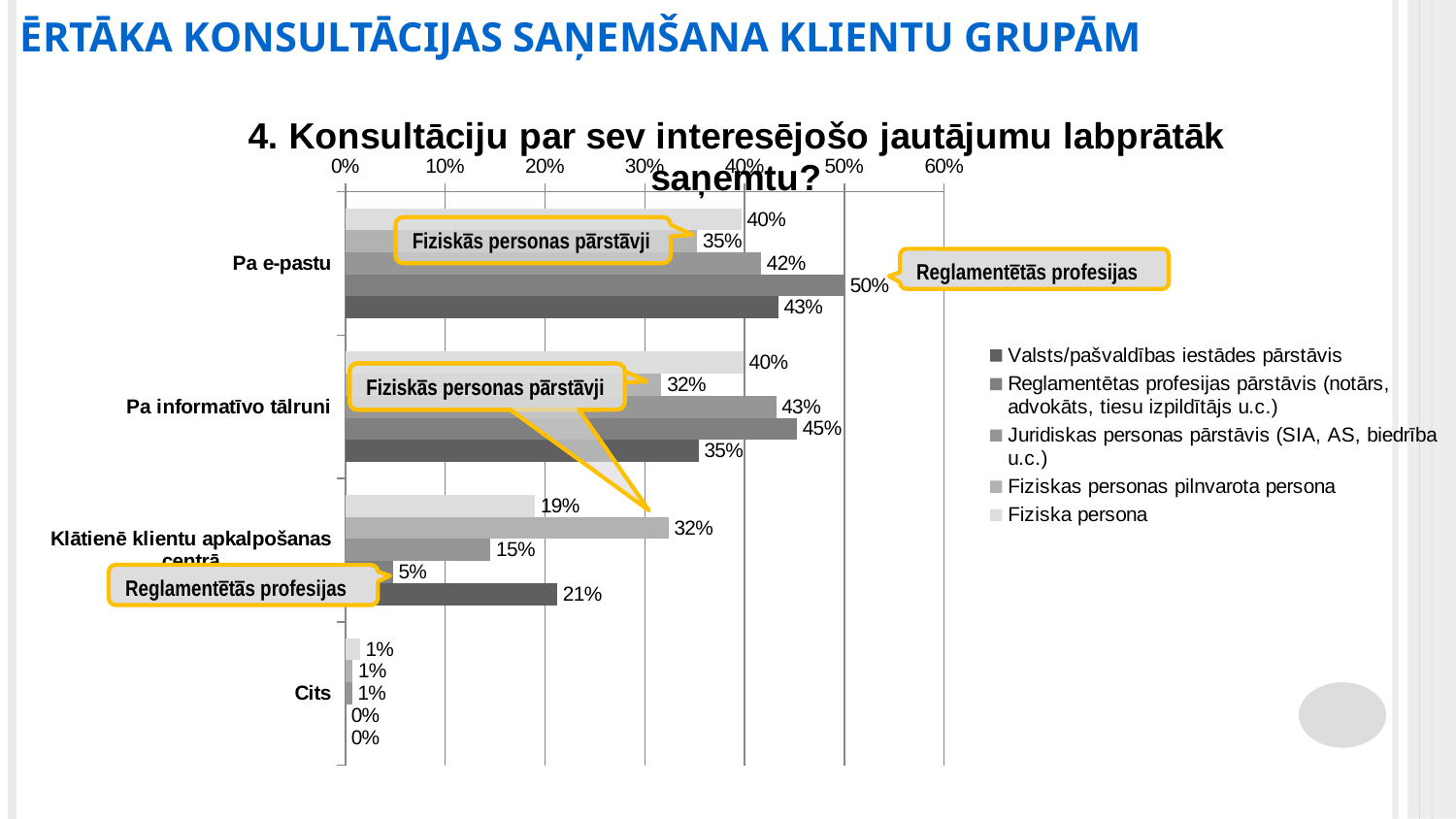
How many series does the legend list? 5 What is the lowest value shown for the category 'Klātienē klientu apkalpošanas centrā'? 5% What is the title of the chart? 4. Konsultāciju par sev interesējošo jautājumu labprātāk saņemtu? What is the highest value shown for the category 'Pa informatīvo tālruni'? 45% What is the value of the bar labelled with the 'Reglamentētās profesijas' callout in the 'Pa e-pastu' category? 50% How many categories are shown on the vertical axis of the chart? 4 Which category has the bar with the highest value in the whole chart? Pa e-pastu What is the highest value shown for the category 'Pa e-pastu'? 50% What is the value of the bar labelled with the 'Reglamentētās profesijas' callout in the 'Klātienē klientu apkalpošanas centrā' category? 5% What type of chart is shown on the slide? bar chart Which is larger: the top (lightest) bar for 'Pa e-pastu' or the top (lightest) bar for 'Klātienē klientu apkalpošanas centrā'? Pa e-pastu What is the difference between the highest value (50%) and the lowest value (35%) in the 'Pa e-pastu' category? 15%